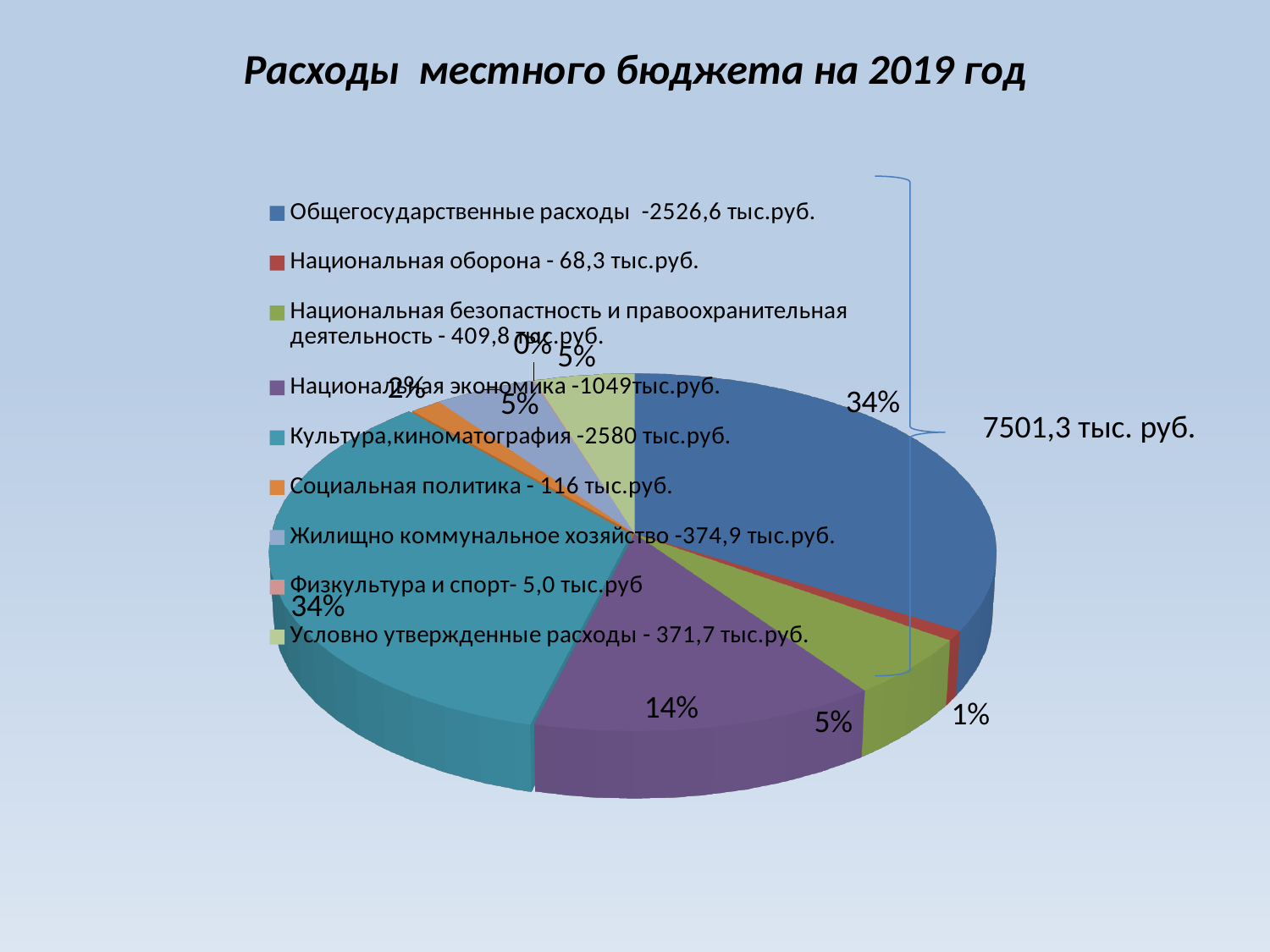
What amount is given for Национальная оборона in the legend? 68,3 тыс.руб. What share of the pie does Социальная политика take? 2% What share of the pie does Национальная экономика take? 14% Which category has the smallest amount in the legend? Физкультура и спорт What is the difference between the amounts for Социальная политика and Национальная оборона? 47,7 тыс.руб. What amount is given for Культура,киноматография in the legend? 2580 тыс.руб. What is the title of the chart? Расходы местного бюджета на 2019 год What kind of chart is shown on the slide? pie chart How many categories does the legend list? 9 Which is larger: the amount for Национальная экономика or for Национальная безопастность и правоохранительная деятельность? Национальная экономика What is the total amount of expenditures shown next to the pie? 7501,3 тыс. руб. What amount is given for Жилищно коммунальное хозяйство in the legend? 374,9 тыс.руб.